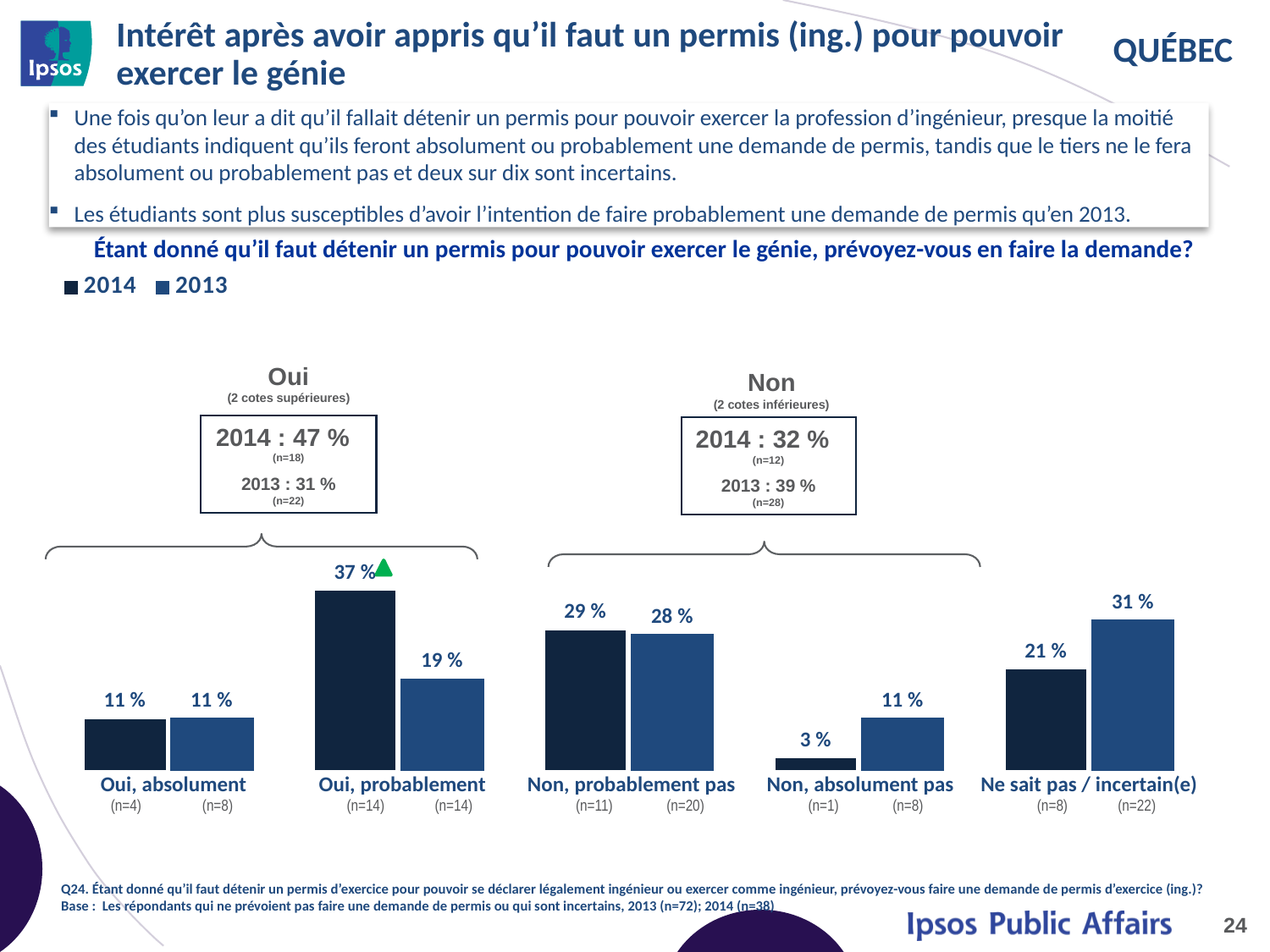
How many categories are shown on the x axis of the chart? 5 What is the 2014 value for "Oui, probablement"? 37 % What is the 2013 value for "Non, probablement pas"? 28 % What is the 2014 value for "Non, absolument pas"? 3 % Which category has the lowest 2014 value? Non, absolument pas What are the two series listed in the legend? 2014 and 2013 Which category has the highest 2014 value? Oui, probablement What kind of chart is shown on the slide? Bar chart What is the difference between the 2014 and 2013 values for "Oui, probablement"? 18 % How many series does the legend list? 2 For "Ne sait pas / incertain(e)", which year has the larger value, 2014 or 2013? 2013 What is the 2013 value for "Ne sait pas / incertain(e)"? 31 %